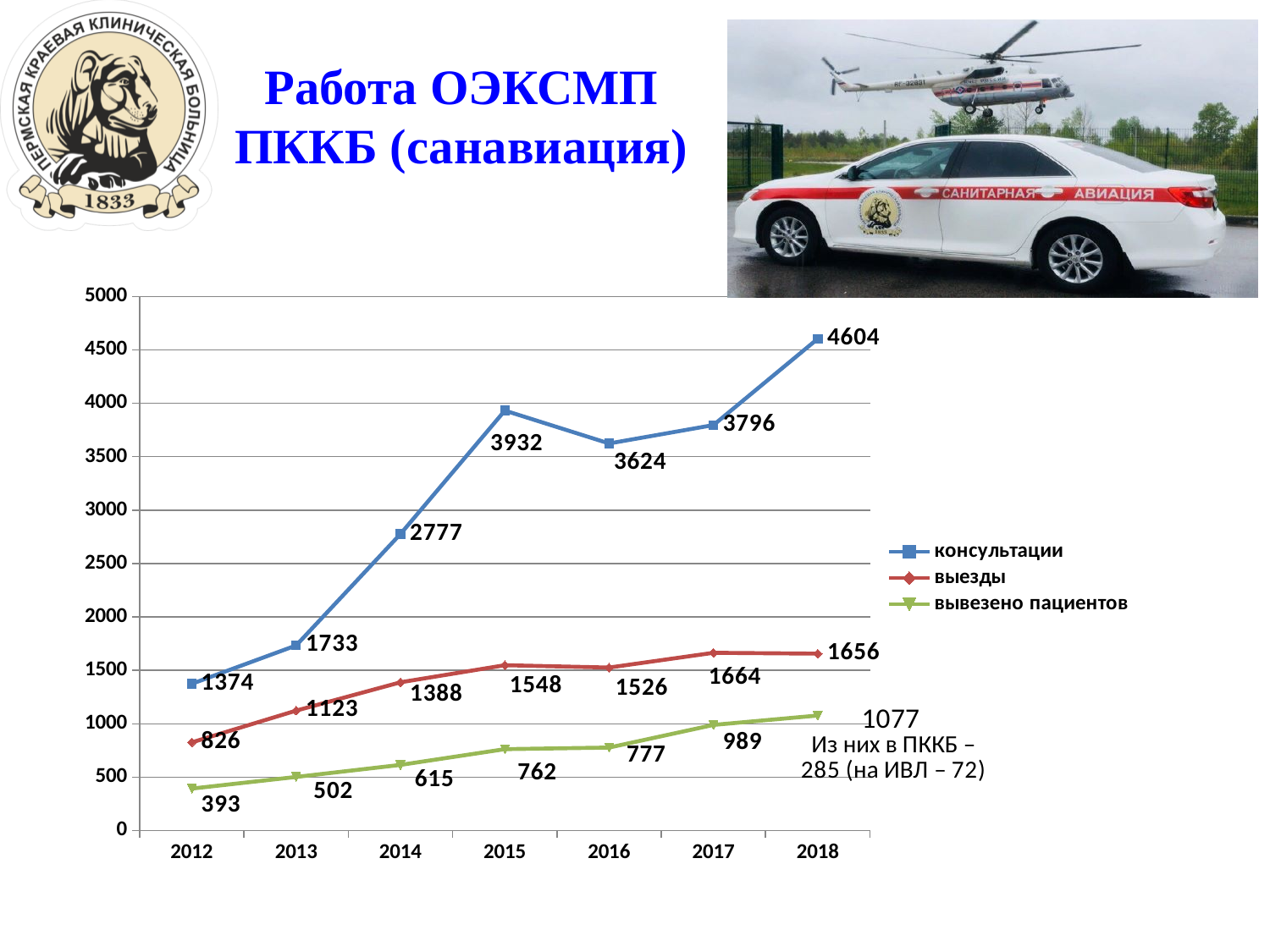
Does the value of вывезено пациентов generally rise or fall from 2012 to 2018? rise What type of chart is shown on the slide? line chart In which year is the value of выезды lowest? 2012 In which year is the value of консультации highest? 2018 Which series is drawn in green? вывезено пациентов What is the value of вывезено пациентов in 2012? 393 Which is larger: выезды in 2017 or выезды in 2018? выезды in 2017 What is the value of консультации in 2018? 4604 How many series does the legend list? 3 How many years are plotted on the x axis? 7 What is the value of выезды in 2015? 1548 What is the difference between консультации in 2015 and in 2016? 308